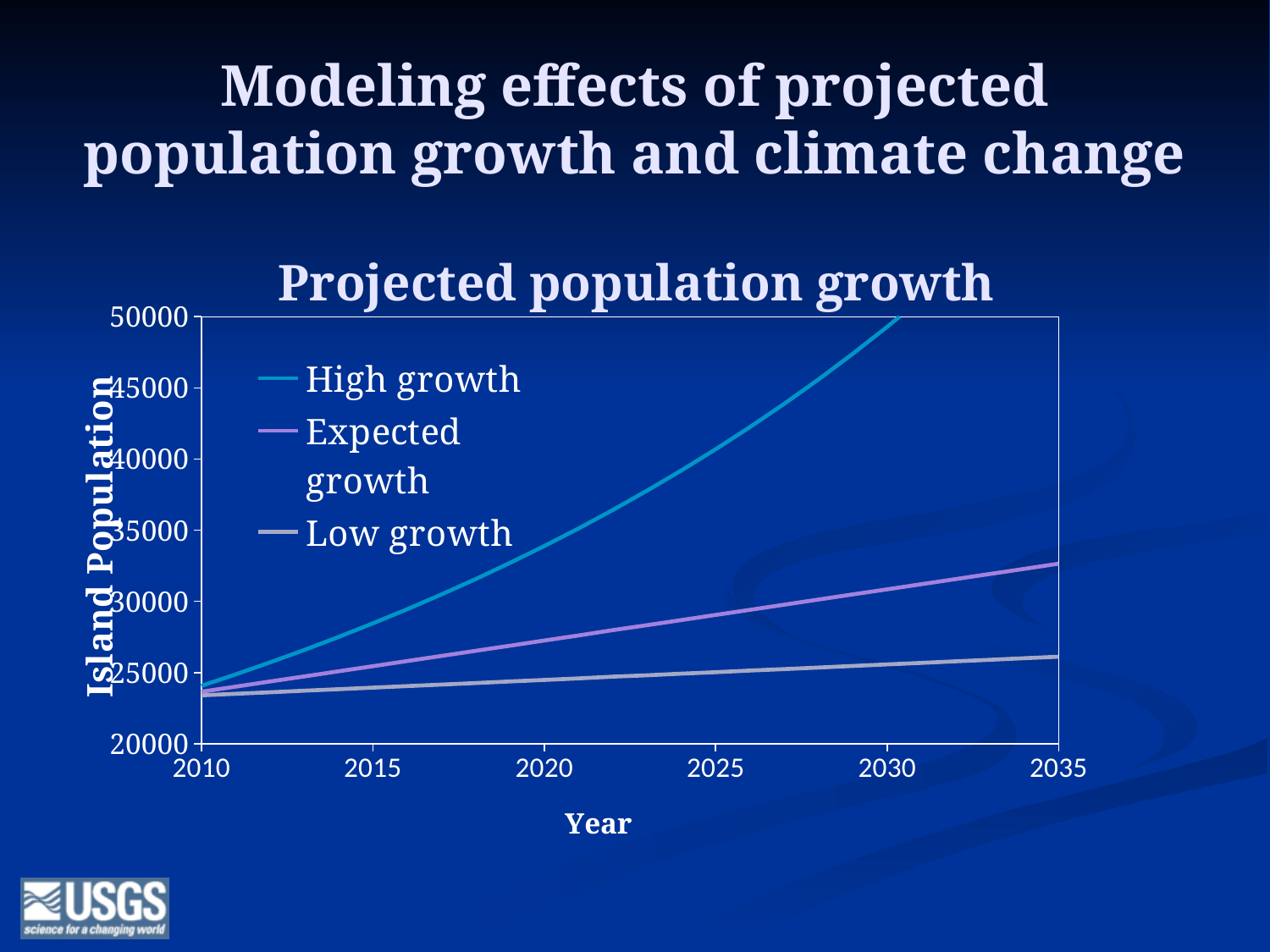
In the "Projected population growth" chart, is the High growth value in 2025 greater or less than 35000? greater In the "Projected population growth" chart, does the High growth line rise or fall from 2010 to 2035? rise What is the label of the horizontal axis in the "Projected population growth" chart? Year Which series in the "Projected population growth" chart has the highest value in 2035? High growth How many series does the legend of the "Projected population growth" chart list? 3 What is the label of the vertical axis in the "Projected population growth" chart? Island Population In the "Projected population growth" chart, is the Expected growth value in 2020 greater or less than 25000? greater In the "Projected population growth" chart, which is larger in 2030: the High growth value or the Low growth value? High growth In the "Projected population growth" chart, is the Expected growth value in 2035 greater or less than 30000? greater What kind of chart is shown under the title "Projected population growth"? line chart Which series in the "Projected population growth" chart has the lowest value in 2035? Low growth